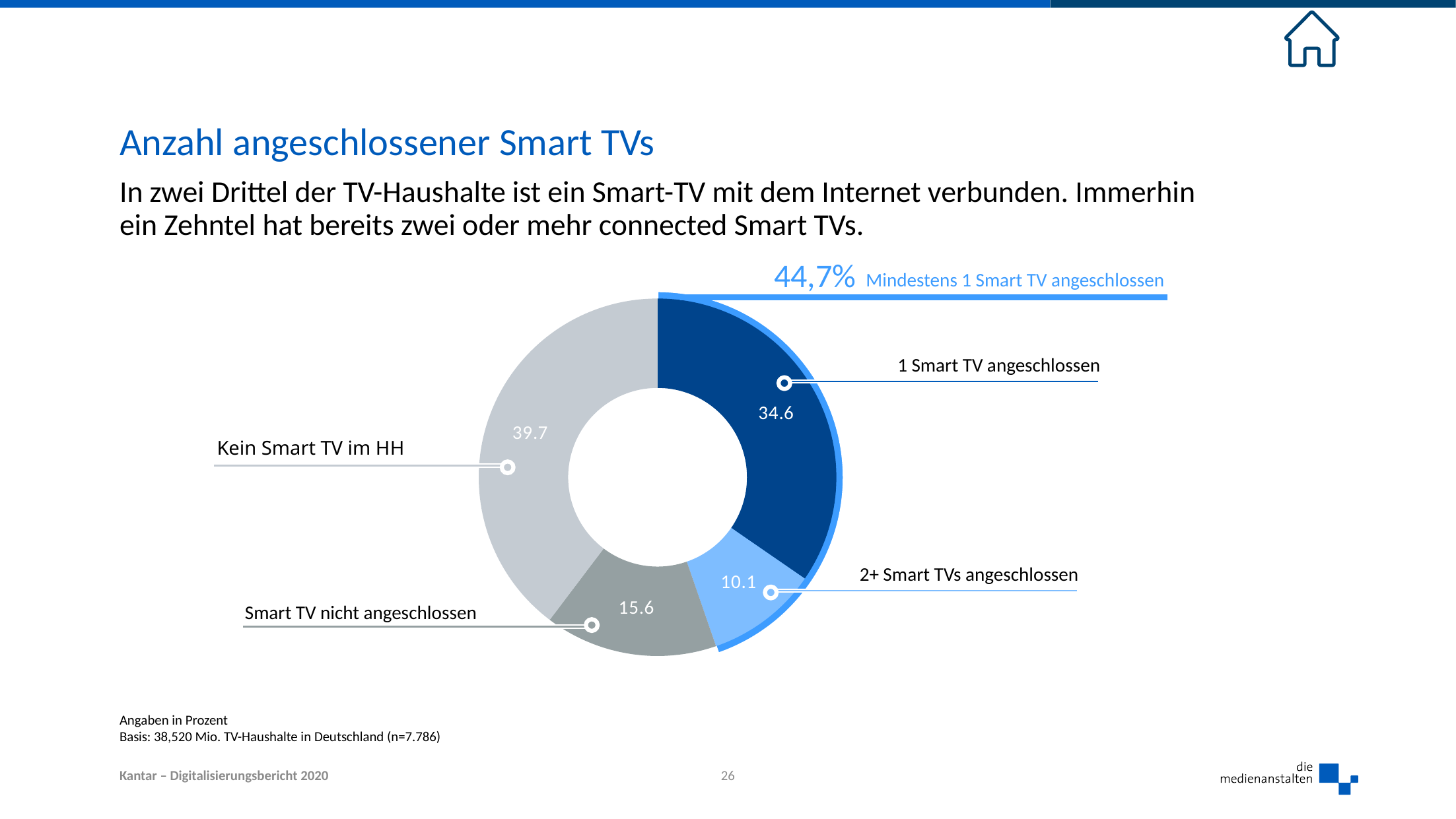
What is the difference between the values for "Kein Smart TV im HH" and "1 Smart TV angeschlossen"? 5.1 Which category has the smallest share of the chart? 2+ Smart TVs angeschlossen What is the value for "Kein Smart TV im HH"? 39.7 What is the title of the slide? Anzahl angeschlossener Smart TVs What percentage is given on the slide for "Mindestens 1 Smart TV angeschlossen"? 44,7% What is the value for "1 Smart TV angeschlossen"? 34.6 What kind of chart is shown on the slide? Pie chart (donut) Which category has the largest share of the chart? Kein Smart TV im HH What is the value for "2+ Smart TVs angeschlossen"? 10.1 Which is larger: the value for "Smart TV nicht angeschlossen" or for "2+ Smart TVs angeschlossen"? Smart TV nicht angeschlossen What is the value for "Smart TV nicht angeschlossen"? 15.6 How many categories does the chart show? 4